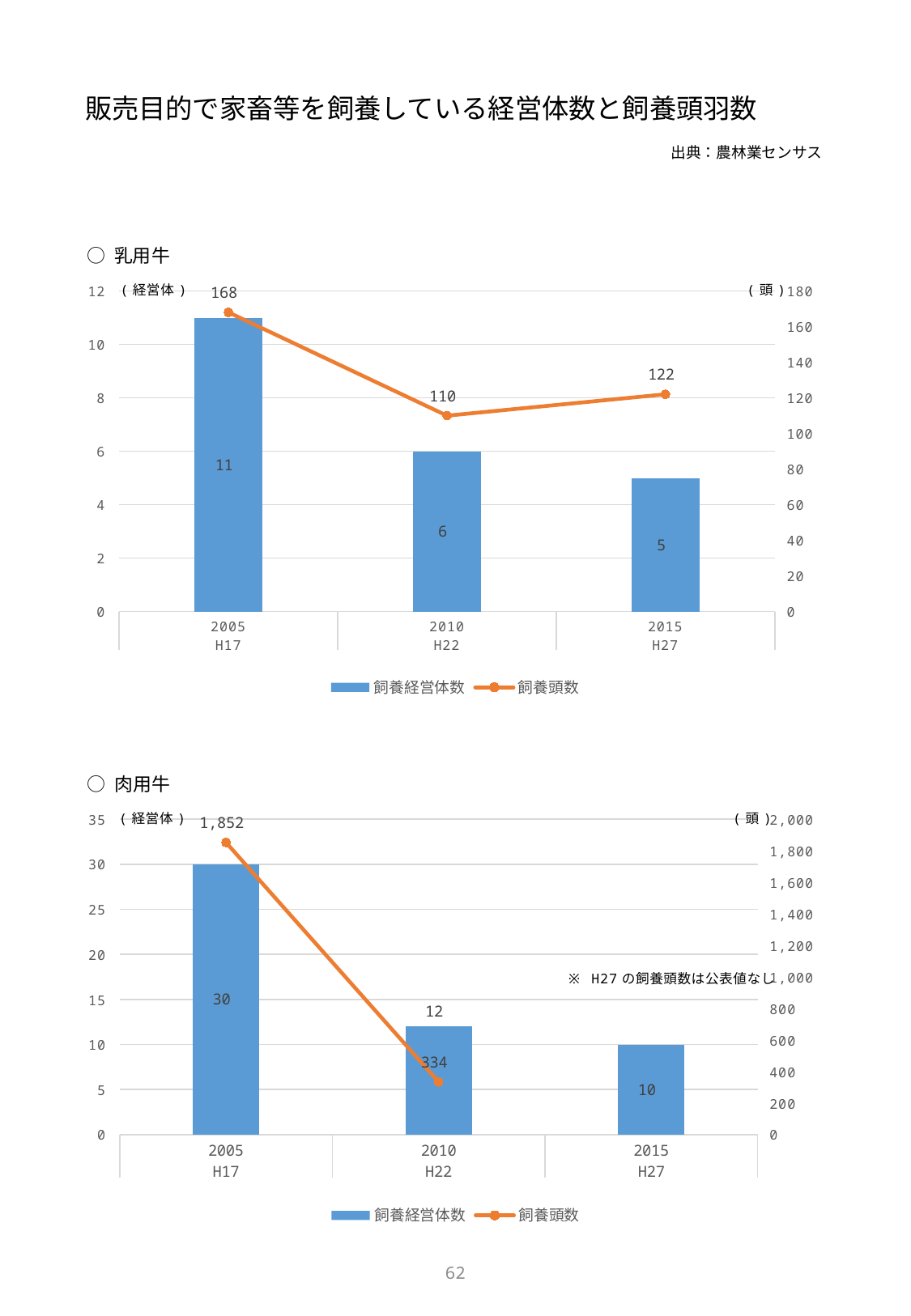
How many series does the legend of the 乳用牛 chart list? 2 In the 肉用牛 chart, is the 飼養頭数 for 2010 (H22) larger or smaller than that for 2005 (H17)? smaller In the 肉用牛 chart, what is the 飼養頭数 value for 2005 (H17)? 1,852 In the 乳用牛 chart, what is the 飼養経営体数 value for 2005 (H17)? 11 In the 乳用牛 chart, does the 飼養経営体数 rise or fall from 2005 to 2015? fall In the 肉用牛 chart, what is the difference in 飼養経営体数 between 2005 (H17) and 2010 (H22)? 18 In the 乳用牛 chart, what is the 飼養頭数 value for 2010 (H22)? 110 In the 肉用牛 chart, what is the 飼養経営体数 value for 2015 (H27)? 10 In the 乳用牛 chart, which year has the highest 飼養頭数? 2005 (H17) In the 乳用牛 chart, what is the difference in 飼養頭数 between 2005 (H17) and 2015 (H27)? 46 In the 肉用牛 chart, which year has the lowest 飼養経営体数? 2015 (H27) How many years (categories) are shown on the x axis of the 肉用牛 chart? 3